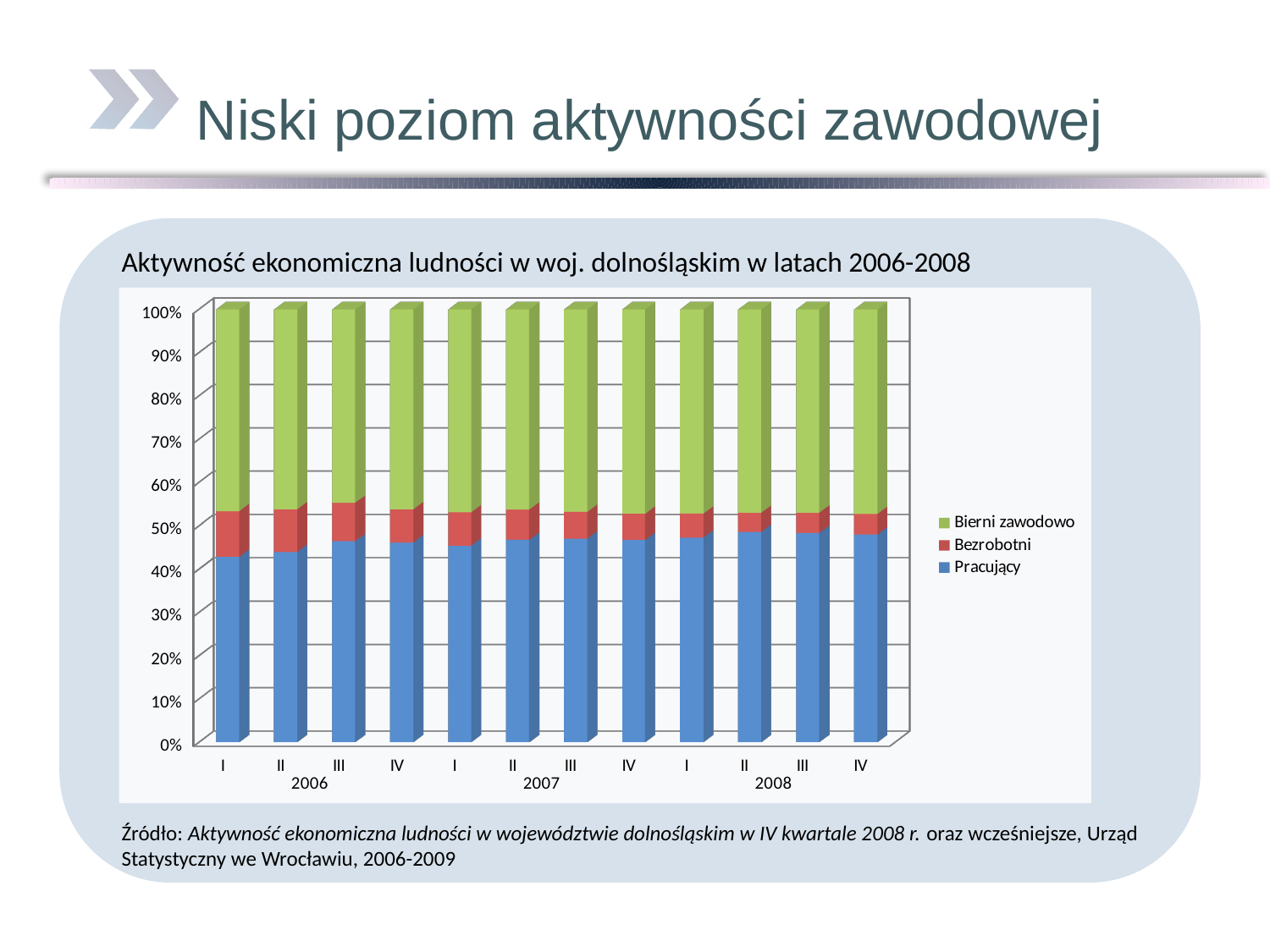
How many bars (quarters) are plotted in the chart? 12 Does the share of Bezrobotni generally rise or fall from 2006 to 2008? fall Which series is shown in green in the chart? Bierni zawodowo Is the share of Pracujący in quarter I of 2006 greater or less than 50%? less What is the title of the chart? Aktywność ekonomiczna ludności w woj. dolnośląskim w latach 2006-2008 What is the total of each stacked bar in the chart? 100% How many series does the chart legend list? 3 Is the share of Pracujący in quarter IV of 2008 greater or less than 50%? less Is the share of Bierni zawodowo in quarter I of 2006 greater or less than 40%? greater What kind of chart is shown on the slide? Stacked bar chart Which is larger: the share of Pracujący in quarter I of 2006 or in quarter IV of 2008? Quarter IV of 2008